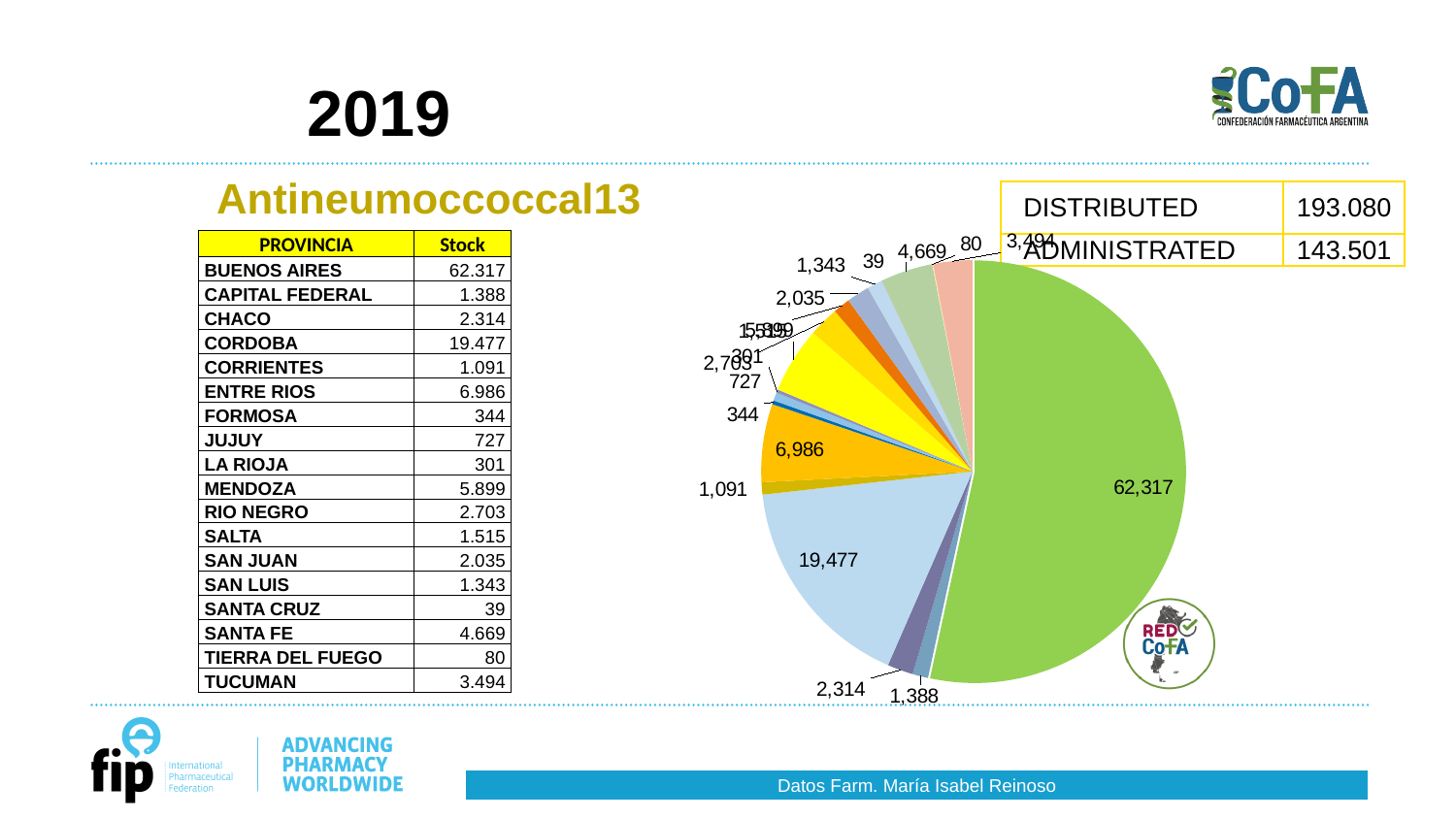
What colour is the largest slice of the pie chart? green Which is larger in the pie chart: the slice labelled 19,477 or the slice labelled 6,986? 19,477 What is the name of the vaccine shown above the table and pie chart? Antineumoccoccal13 What is the value of the second largest slice in the pie chart? 19,477 What is the value of the smallest slice in the pie chart? 39 What is the difference between the slices labelled 6,986 and 1,091 in the pie chart? 5,895 Which is larger in the pie chart: the slice labelled 2,314 or the slice labelled 1,388? 2,314 What type of chart is shown on the slide? pie chart According to the table on the slide, which province does the largest pie slice (62,317) correspond to? Buenos Aires What is the difference between the largest slice (62,317) and the second largest slice (19,477) in the pie chart? 42,840 What is the value of the largest slice in the pie chart? 62,317 How many slices does the pie chart have? 18